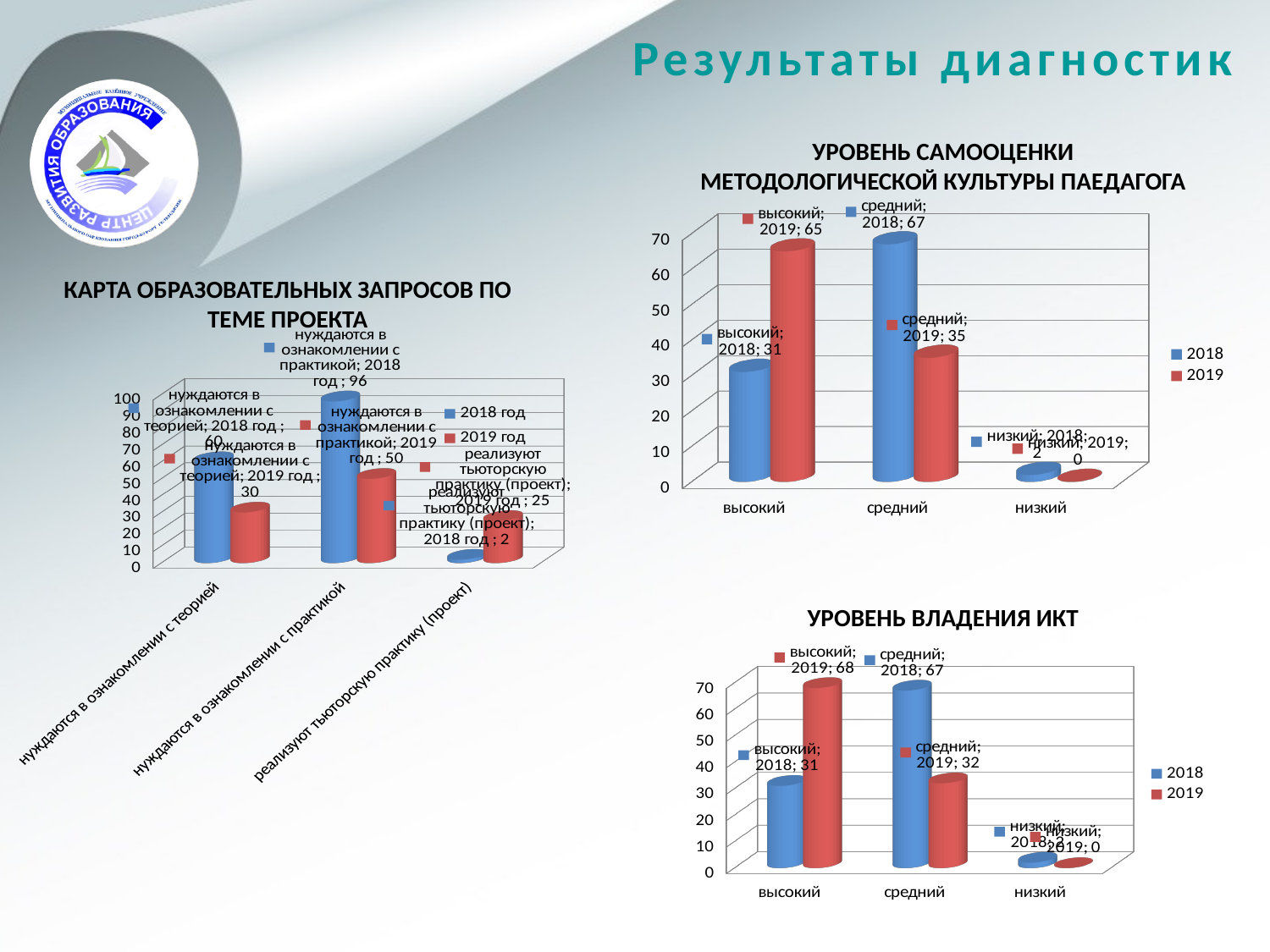
In the chart 'УРОВЕНЬ САМООЦЕНКИ МЕТОДОЛОГИЧЕСКОЙ КУЛЬТУРЫ ПАЕДАГОГА', which category has the lowest value for 2019? низкий In the chart 'УРОВЕНЬ ВЛАДЕНИЯ ИКТ', what is the value for 'средний' in 2019? 32 In the chart 'УРОВЕНЬ САМООЦЕНКИ МЕТОДОЛОГИЧЕСКОЙ КУЛЬТУРЫ ПАЕДАГОГА', what is the difference between the 2019 and 2018 values for 'высокий'? 34 In the chart 'УРОВЕНЬ САМООЦЕНКИ МЕТОДОЛОГИЧЕСКОЙ КУЛЬТУРЫ ПАЕДАГОГА', what is the value for 'средний' in 2018? 67 In the chart 'КАРТА ОБРАЗОВАТЕЛЬНЫХ ЗАПРОСОВ ПО ТЕМЕ ПРОЕКТА', what is the value for 'реализуют тьюторскую практику (проект)' in 2019? 25 In the chart 'УРОВЕНЬ ВЛАДЕНИЯ ИКТ', which category has the highest value for 2018? средний In the chart 'КАРТА ОБРАЗОВАТЕЛЬНЫХ ЗАПРОСОВ ПО ТЕМЕ ПРОЕКТА', what is the value for 'нуждаются в ознакомлении с практикой' in 2018? 96 In the chart 'КАРТА ОБРАЗОВАТЕЛЬНЫХ ЗАПРОСОВ ПО ТЕМЕ ПРОЕКТА', which is larger for 'нуждаются в ознакомлении с теорией': the 2018 value or the 2019 value? 2018 In the chart 'УРОВЕНЬ САМООЦЕНКИ МЕТОДОЛОГИЧЕСКОЙ КУЛЬТУРЫ ПАЕДАГОГА', what is the value for 'высокий' in 2019? 65 In the chart 'УРОВЕНЬ ВЛАДЕНИЯ ИКТ', what is the value for 'высокий' in 2019? 68 What kind of chart is 'УРОВЕНЬ ВЛАДЕНИЯ ИКТ'? bar chart In the chart 'УРОВЕНЬ ВЛАДЕНИЯ ИКТ', how many series does the legend list? 2